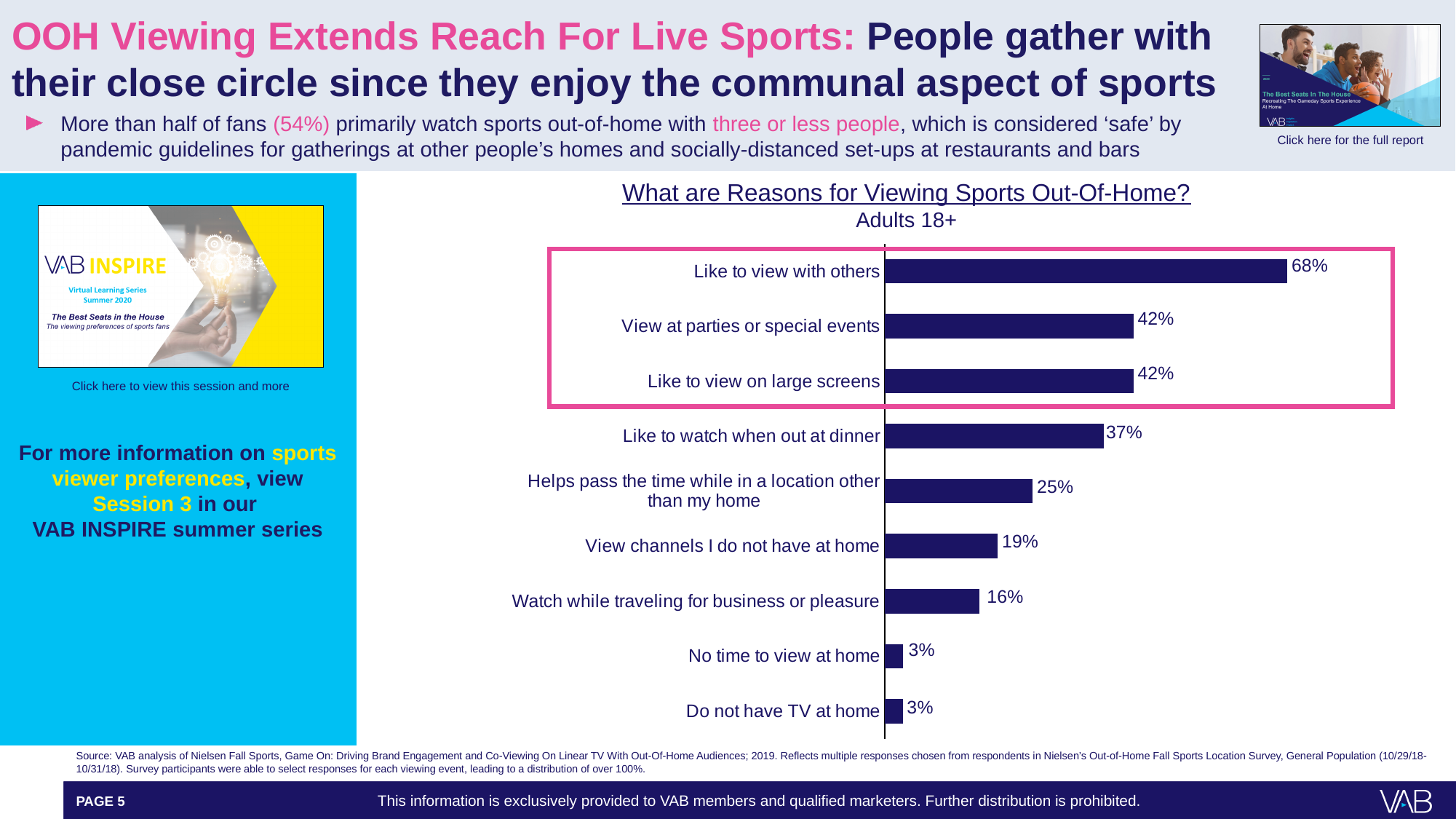
What is the value for 'Watch while traveling for business or pleasure'? 16% What is the difference between 'View channels I do not have at home' and 'No time to view at home'? 16% What is the value for 'Like to watch when out at dinner'? 37% What is the difference between 'Like to view with others' and 'View at parties or special events'? 26% How many reasons (categories) are shown in the chart? 9 What is the value for 'Helps pass the time while in a location other than my home'? 25% What is the title of the chart? What are Reasons for Viewing Sports Out-Of-Home? What percentage of adults 18+ cite 'Like to view with others' as a reason for viewing sports out-of-home? 68% Which reason has the highest value in the chart? Like to view with others Which is larger: 'Like to watch when out at dinner' or 'View channels I do not have at home'? Like to watch when out at dinner Do the values rise or fall going from the top bar to the bottom bar? Fall What type of chart is used to show the reasons for viewing sports out-of-home? Bar chart